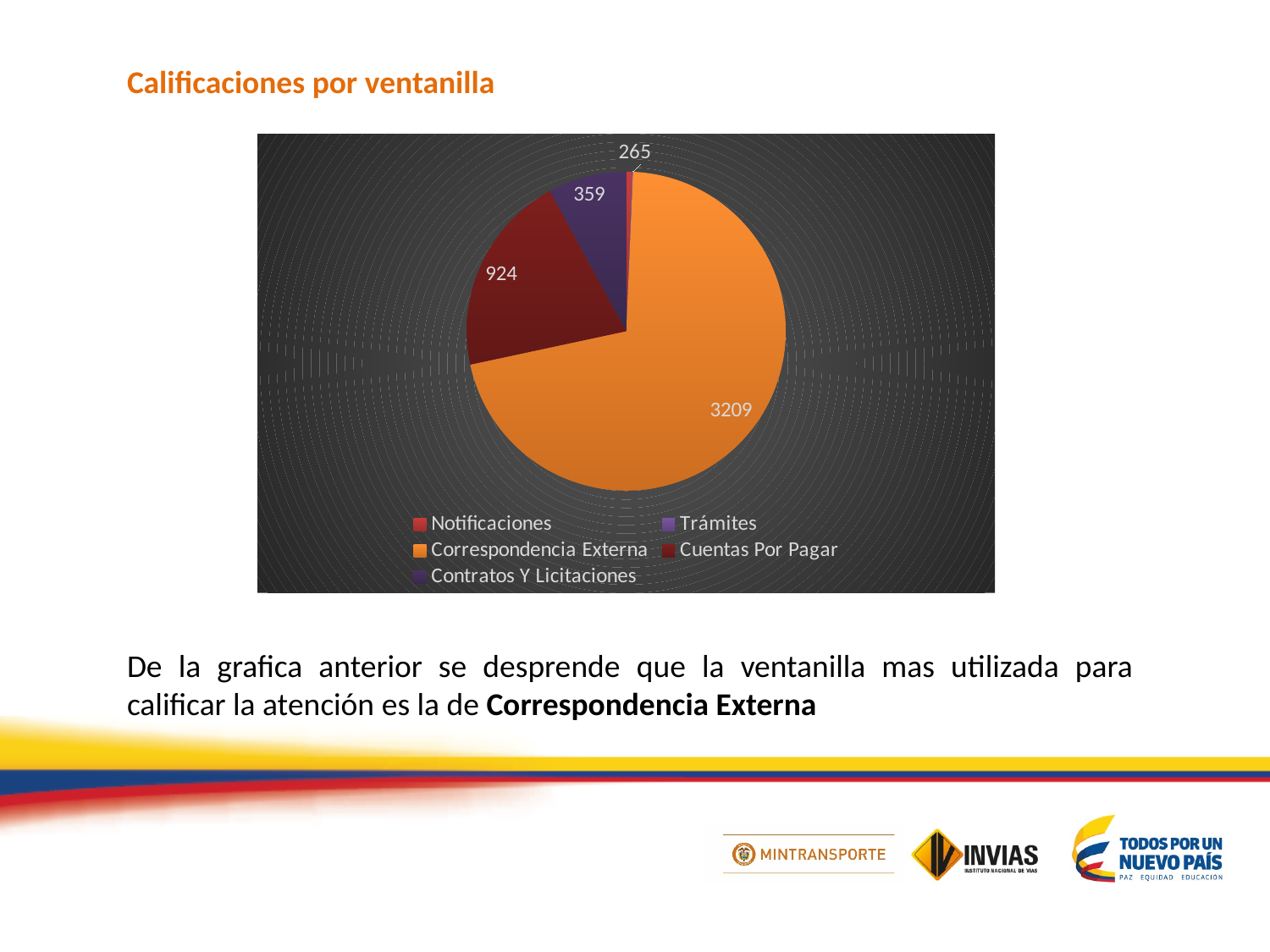
Which category has the largest slice of the pie? Correspondencia Externa Which is larger, Cuentas Por Pagar or Contratos Y Licitaciones? Cuentas Por Pagar What is the value shown for Correspondencia Externa? 3209 What is the value shown for Contratos Y Licitaciones? 359 What is the value shown for Cuentas Por Pagar? 924 What is the difference between the values for Correspondencia Externa and Cuentas Por Pagar? 2285 What colour is the Correspondencia Externa slice? Orange What kind of chart is shown on the slide? Pie chart How many categories does the legend list? 5 What is the difference between the values for Cuentas Por Pagar and Contratos Y Licitaciones? 565 What is the title above the chart? Calificaciones por ventanilla Which is larger, Correspondencia Externa or Cuentas Por Pagar? Correspondencia Externa